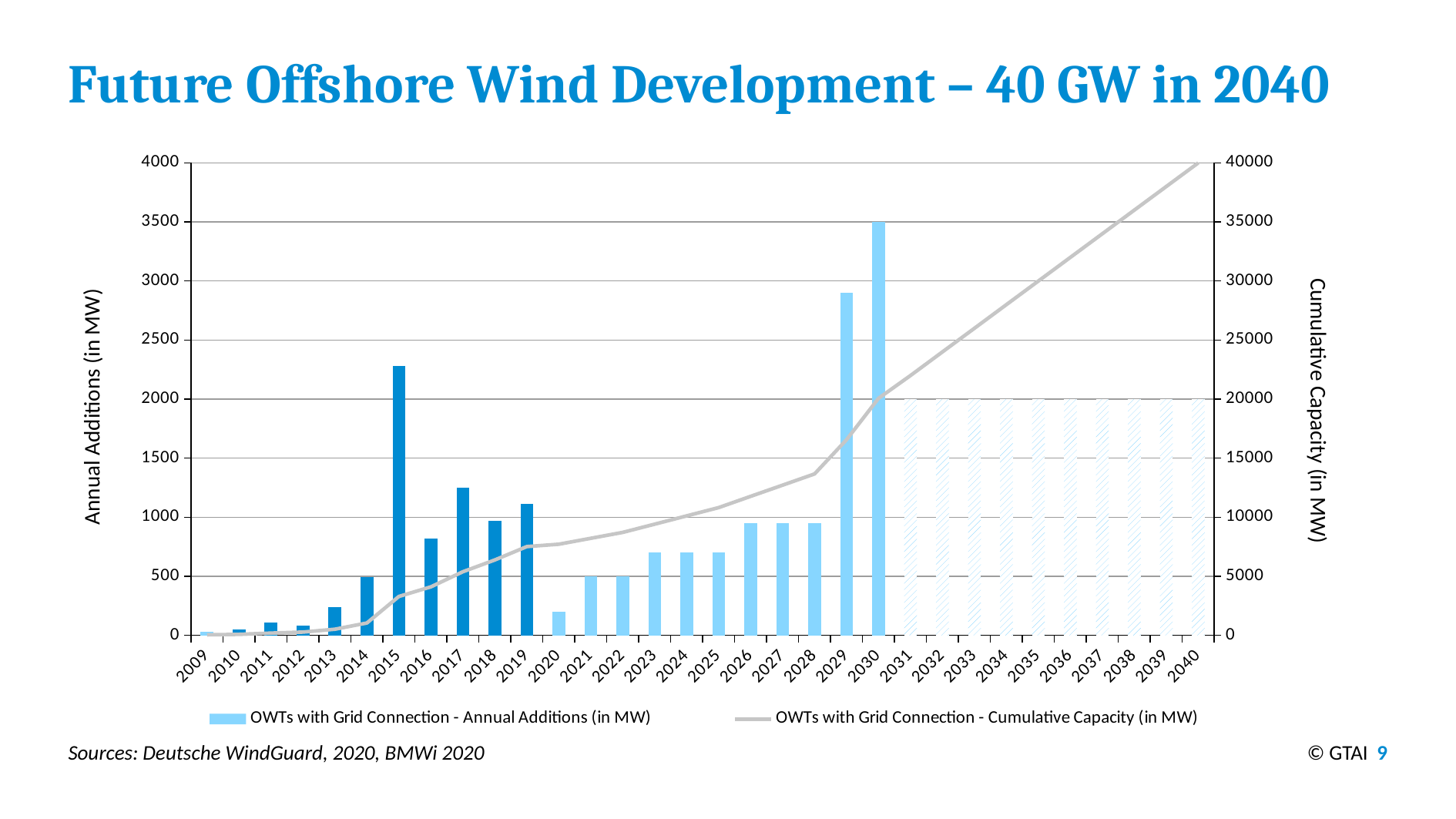
Which year has the highest annual additions bar? 2030 Is the annual additions value for 2015 greater or less than 2000? greater What is the annual additions value for 2030 in MW? 3500 What kind of chart is shown on the slide? A combined bar and line chart Which year has larger annual additions, 2015 or 2017? 2015 How many series does the legend list? 2 Is the annual additions value for 2020 greater or less than 500? less How many years are shown on the x axis? 32 What is the title of the chart on the slide? Future Offshore Wind Development – 40 GW in 2040 What is the label of the right-hand vertical axis? Cumulative Capacity (in MW) What is the cumulative capacity reached in 2040 in MW? 40000 Does the cumulative capacity line rise or fall from 2009 to 2040? Rises